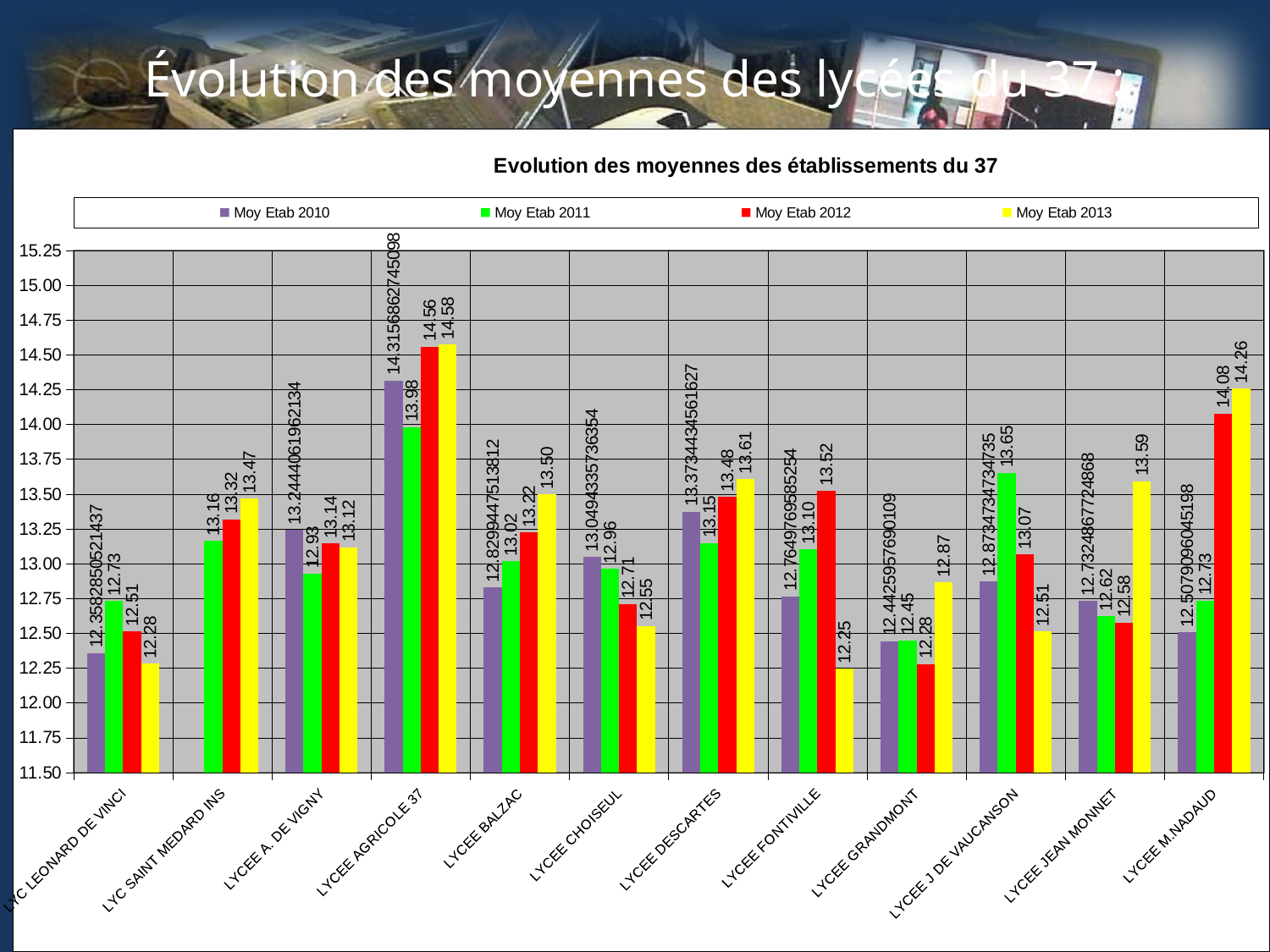
Is the Moy Etab 2010 value for LYC LEONARD DE VINCI greater or less than 12.50? less What is the Moy Etab 2013 value for LYCEE AGRICOLE 37? 14.58 For LYCEE JEAN MONNET, which is larger: the Moy Etab 2012 value or the Moy Etab 2013 value? Moy Etab 2013 How many lycées (categories) are shown on the x axis? 12 What is the Moy Etab 2012 value for LYCEE M.NADAUD? 14.08 What is the Moy Etab 2011 value for LYCEE J DE VAUCANSON? 13.65 What type of chart is shown on the slide? bar chart Which lycée has the lowest Moy Etab 2013 value? LYCEE FONTIVILLE How many series does the legend list? 4 For LYCEE BALZAC, do the values rise or fall from Moy Etab 2010 to Moy Etab 2013? rise What is the difference between the Moy Etab 2013 and Moy Etab 2012 values for LYCEE M.NADAUD? 0.18 Which lycée has the highest Moy Etab 2013 value? LYCEE AGRICOLE 37